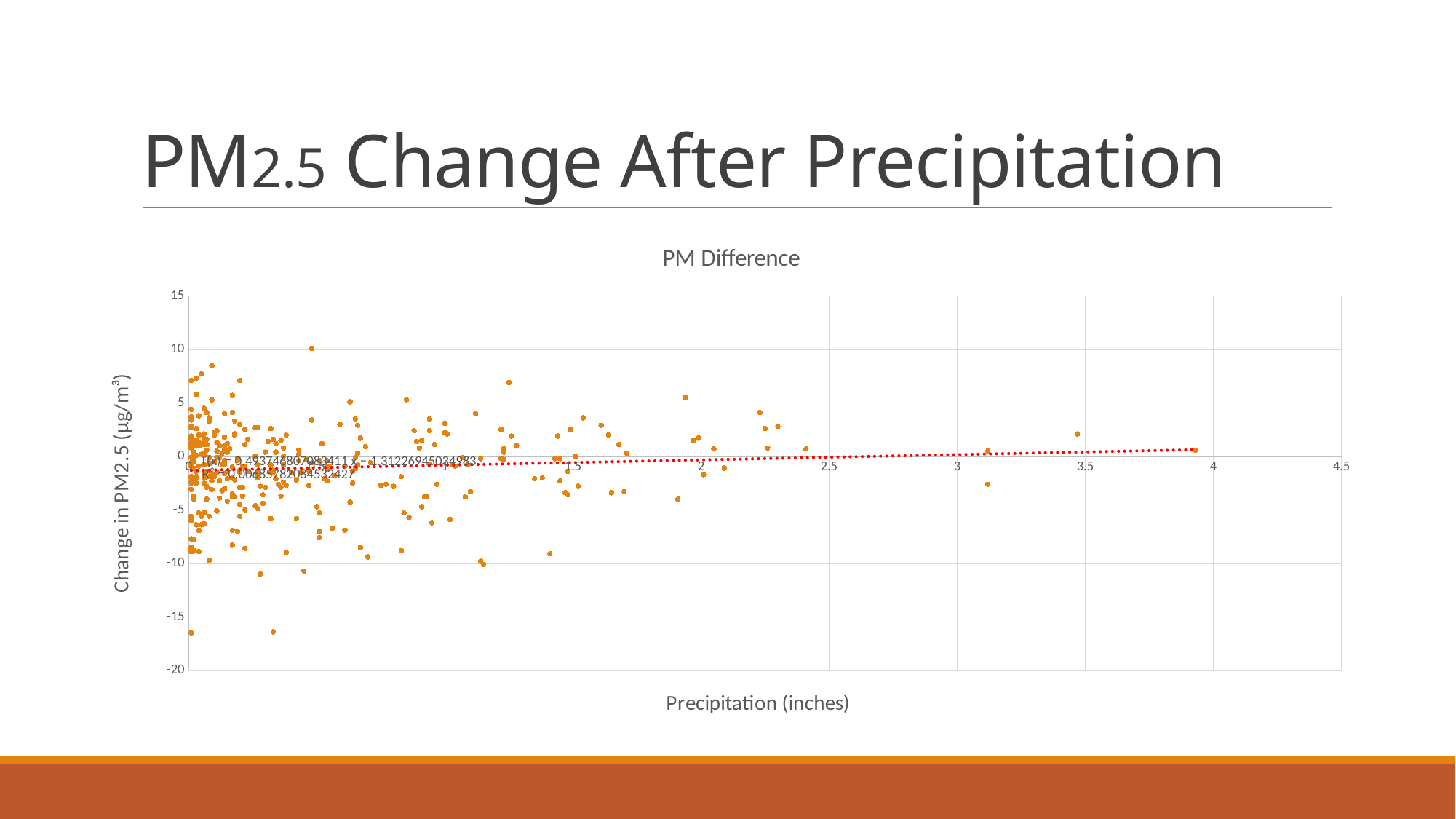
What kind of chart is shown on the slide? scatter chart Does the dotted trendline rise or fall as precipitation increases along the x axis? rise What is the title of the chart? PM Difference What is the lowest value shown on the y axis of the chart? -20 What is the highest value shown on the x axis of the chart? 4.5 What is the label of the x axis of the chart? Precipitation (inches) Is the highest plotted change in PM2.5 value greater or less than 5? greater What is the highest value shown on the y axis of the chart? 15 Is the lowest plotted change in PM2.5 value greater or less than -15? less At a precipitation of 0 inches, is the trendline value greater or less than 0? less